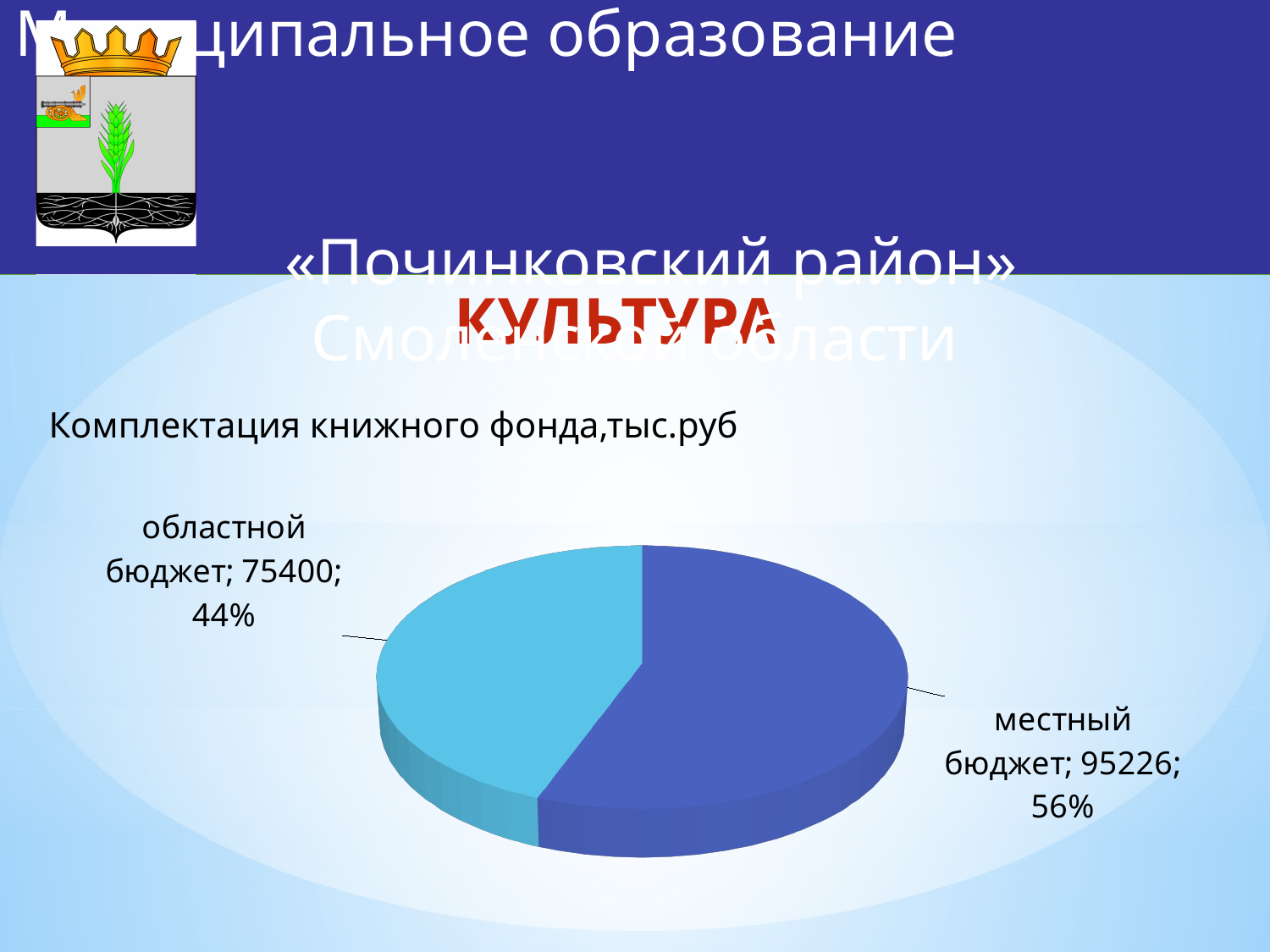
Which is larger, местный бюджет or областной бюджет? местный бюджет What is the difference between the values for местный бюджет and областной бюджет? 19826 What kind of chart is shown on the slide? pie chart Which category has the smallest slice? областной бюджет What is the title of the chart? Комплектация книжного фонда,тыс.руб How many slices does the pie chart have? 2 What share of the pie does местный бюджет take? 56% What is the value for областной бюджет? 75400 What is the value for местный бюджет? 95226 Which category has the largest slice? местный бюджет What is the total of the two slices? 170626 What share of the pie does областной бюджет take? 44%